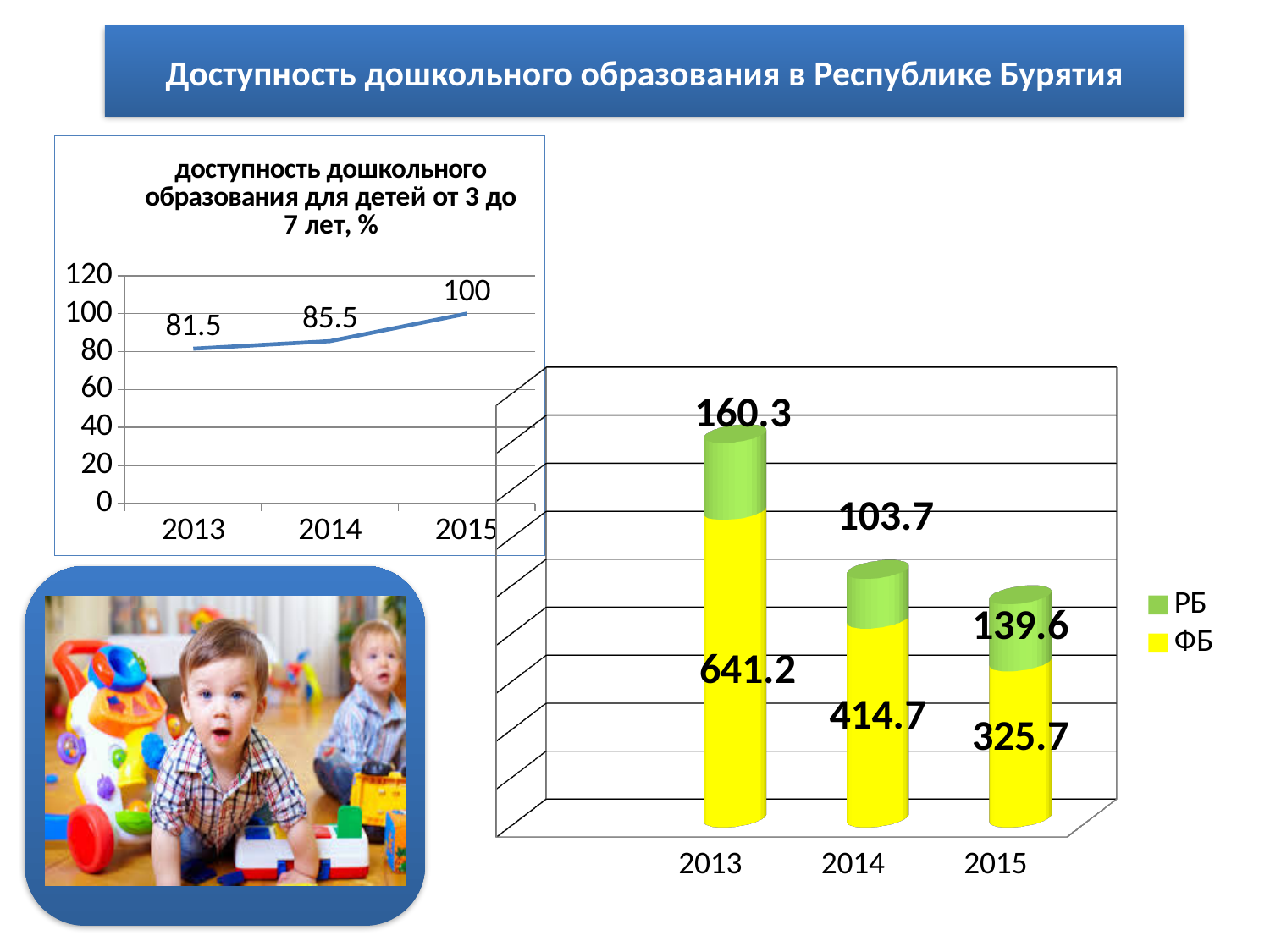
In the line chart titled 'доступность дошкольного образования для детей от 3 до 7 лет, %', what is the value for 2014? 85.5 In the line chart titled 'доступность дошкольного образования для детей от 3 до 7 лет, %', what is the value for 2015? 100 In the line chart titled 'доступность дошкольного образования для детей от 3 до 7 лет, %', how many data points are plotted? 3 In the stacked bar chart on the right of the slide, which year has the highest ФБ value? 2013 In the line chart titled 'доступность дошкольного образования для детей от 3 до 7 лет, %', which year has the lowest value? 2013 In the line chart titled 'доступность дошкольного образования для детей от 3 до 7 лет, %', do the values rise or fall from 2013 to 2015? rise In the stacked bar chart on the right of the slide, what is the РБ value for 2015? 139.6 In the stacked bar chart on the right of the slide, how many series does the legend list? 2 In the stacked bar chart on the right of the slide, which series is shown in yellow? ФБ In the stacked bar chart on the right of the slide, what is the total of the 2013 bar (РБ plus ФБ)? 801.5 In the line chart titled 'доступность дошкольного образования для детей от 3 до 7 лет, %', what is the difference between the 2015 and 2013 values? 18.5 In the stacked bar chart on the right of the slide, what is the ФБ value for 2014? 414.7